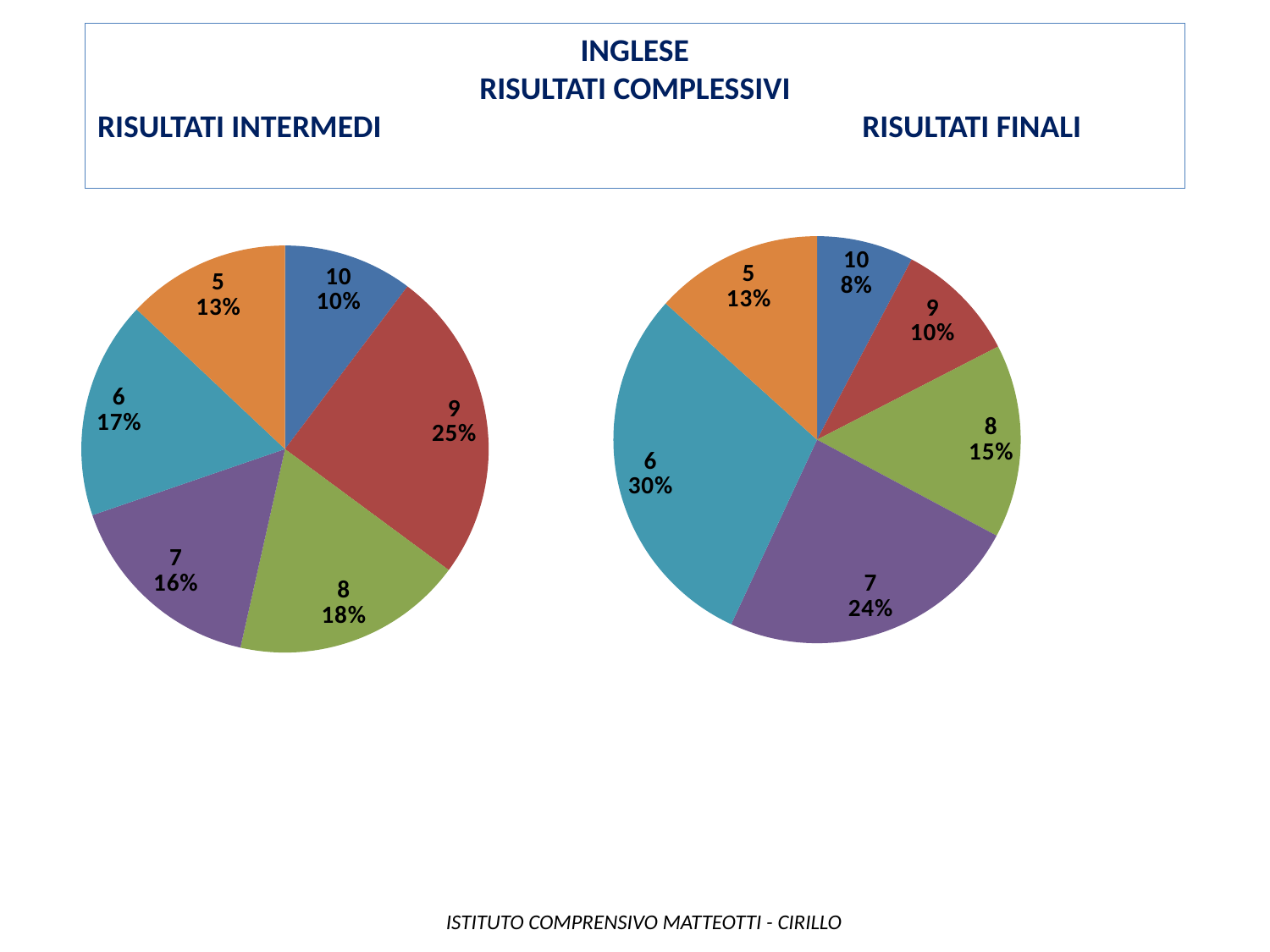
In the RISULTATI INTERMEDI chart, what is the difference between the shares of grade 9 and grade 10? 15% What is the main title shown above the two charts? INGLESE RISULTATI COMPLESSIVI In the RISULTATI FINALI chart, what is the difference between the shares of grade 6 and grade 7? 6% What type of chart is used for RISULTATI INTERMEDI? Pie chart In the RISULTATI INTERMEDI chart, what share does grade 9 have? 25% In the RISULTATI FINALI chart, which grade has the largest slice? 6 How many slices does the RISULTATI INTERMEDI pie chart have? 6 In the RISULTATI INTERMEDI chart, which grade has the largest slice? 9 In the RISULTATI FINALI chart, which is larger, the share of grade 8 or the share of grade 9? 8 In the RISULTATI FINALI chart, what share does grade 6 have? 30% In the RISULTATI INTERMEDI chart, what share does grade 7 have? 16% In the RISULTATI FINALI chart, which grade has the smallest slice? 10